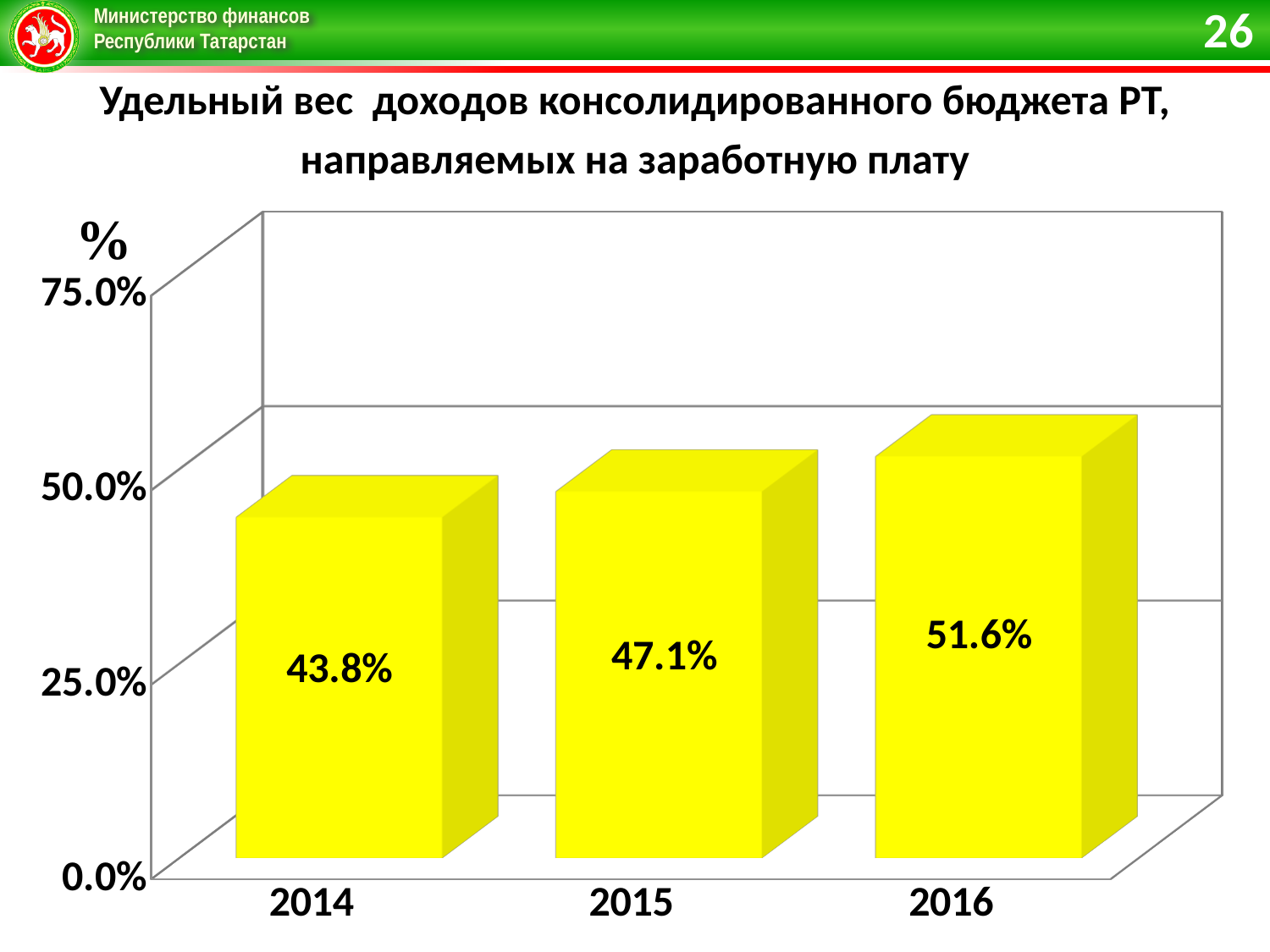
Which year has the lowest value? 2014 Do the values rise or fall from 2014 to 2016? rise What is the difference between the values for 2015 and 2014? 3.3% What kind of chart is this? bar chart What is the difference between the values for 2016 and 2014? 7.8% What is the value for 2015? 47.1% What is the value for 2014? 43.8% Which year has the highest value? 2016 What is the value for 2016? 51.6% Which is larger, the value for 2015 or the value for 2016? 2016 How many years are shown on the x axis? 3 Is the value for 2014 greater or less than 50.0%? less